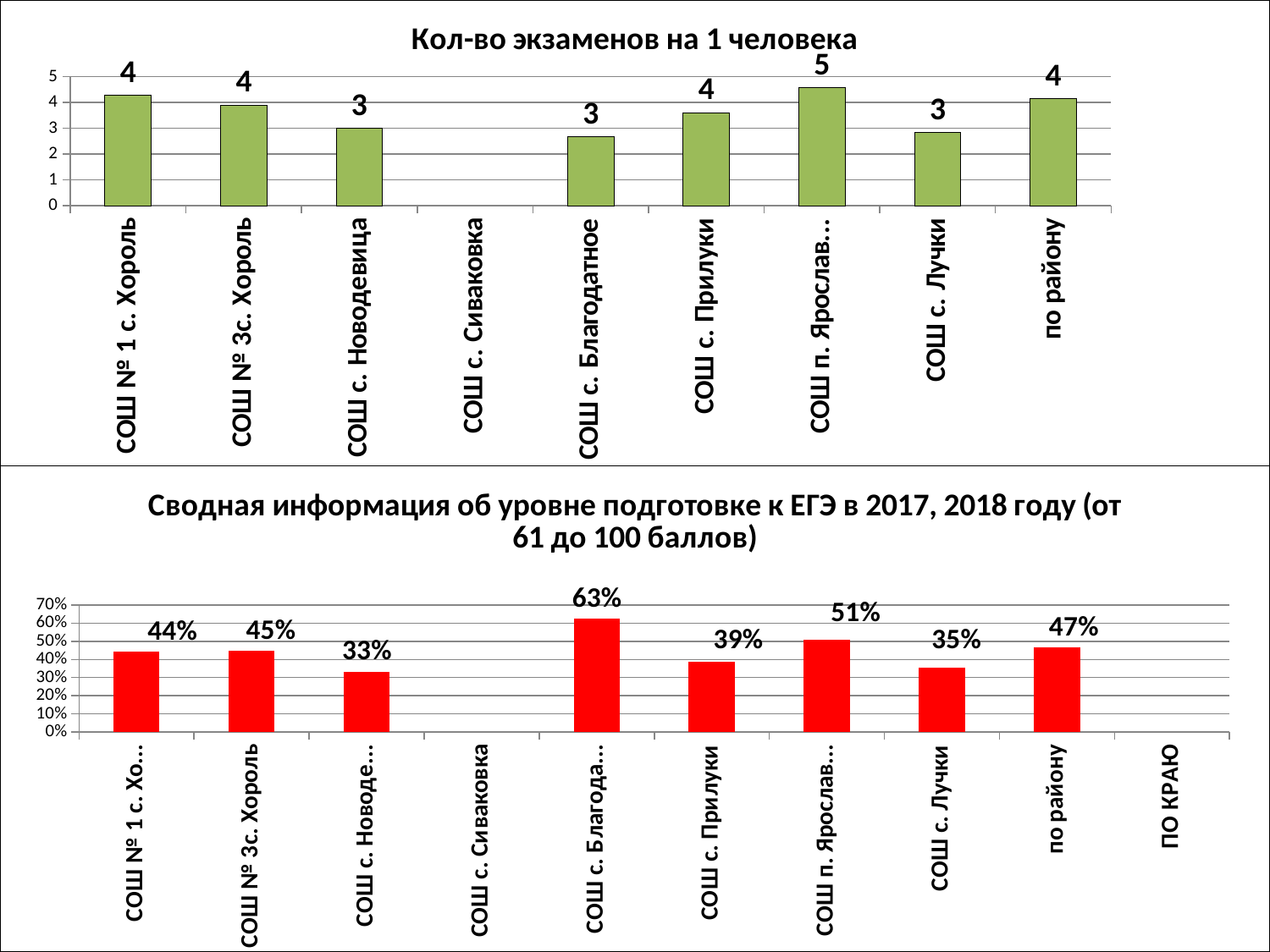
What kind of chart is the top chart 'Кол-во экзаменов на 1 человека'? bar chart In the bottom chart 'Сводная информация об уровне подготовке к ЕГЭ', which plotted category has the lowest value? СОШ с. Новоде... In the top chart 'Кол-во экзаменов на 1 человека', how many bars are plotted? 8 In the top chart 'Кол-во экзаменов на 1 человека', which category has the highest value? СОШ п. Ярослав... What colour are the bars in the bottom chart 'Сводная информация об уровне подготовке к ЕГЭ'? red In the top chart 'Кол-во экзаменов на 1 человека', what is the value for СОШ с. Прилуки? 4 In the bottom chart 'Сводная информация об уровне подготовке к ЕГЭ', which is larger: the value for СОШ № 3с. Хороль or the value for СОШ № 1 с. Хо...? СОШ № 3с. Хороль In the bottom chart 'Сводная информация об уровне подготовке к ЕГЭ', is the value for СОШ п. Ярослав... greater or less than 40%? greater In the bottom chart 'Сводная информация об уровне подготовке к ЕГЭ', what is the value for СОШ с. Прилуки? 39% In the bottom chart 'Сводная информация об уровне подготовке к ЕГЭ', which category has the highest value? СОШ с. Благода... In the top chart 'Кол-во экзаменов на 1 человека', what is the value for СОШ с. Лучки? 3 In the bottom chart 'Сводная информация об уровне подготовке к ЕГЭ', what is the difference between the values for по району and СОШ с. Лучки? 12%